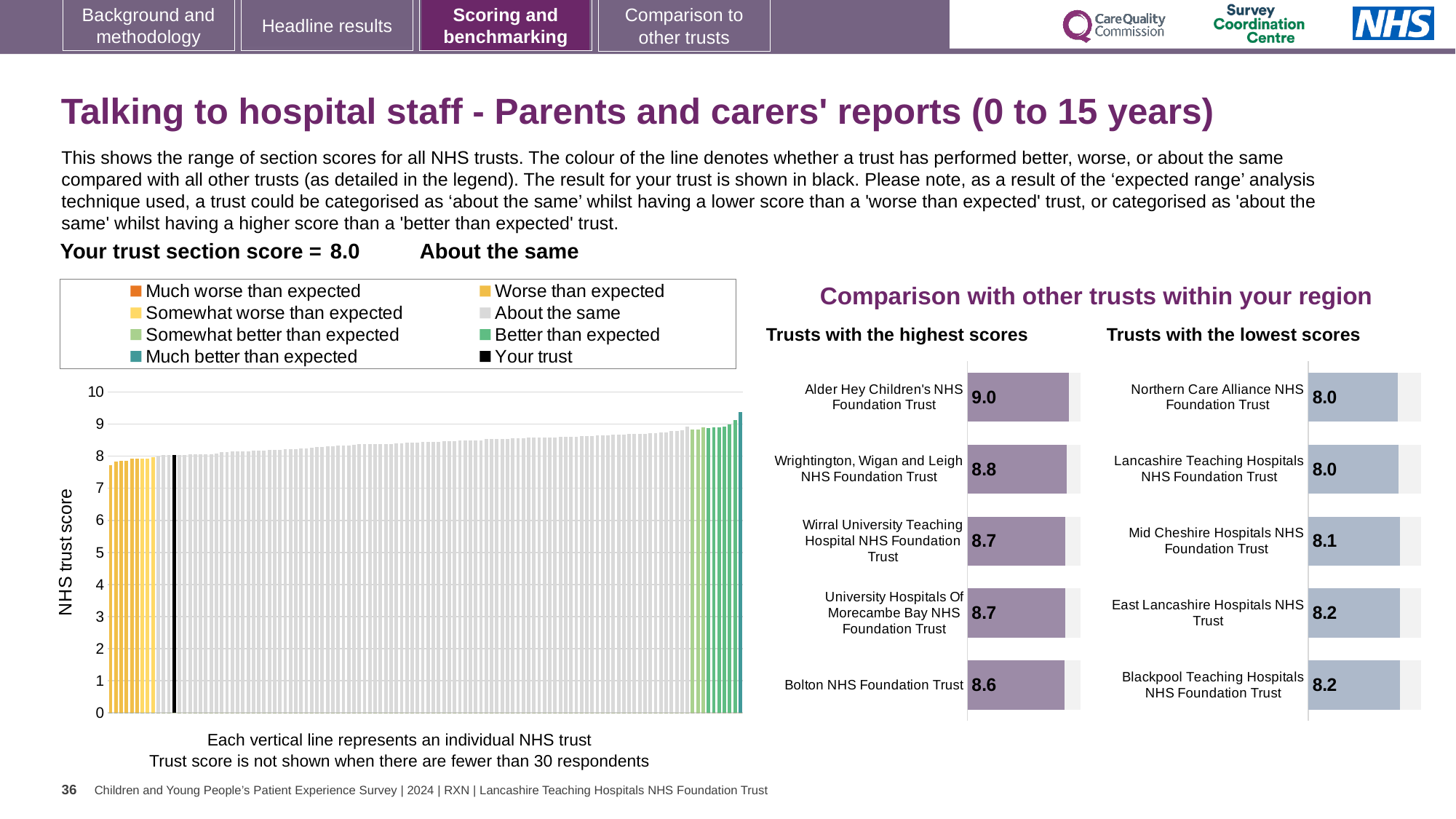
How many entries does the legend of the large chart on the left list? 8 In the large chart on the left, do the trust scores rise or fall from left to right? Rise In the 'Trusts with the lowest scores' chart, what is the difference between the scores of Blackpool Teaching Hospitals NHS Foundation Trust and Northern Care Alliance NHS Foundation Trust? 0.2 In the 'Trusts with the highest scores' chart, how many trusts are shown? 5 In the 'Trusts with the lowest scores' chart, which is larger: the score for Mid Cheshire Hospitals NHS Foundation Trust or East Lancashire Hospitals NHS Trust? East Lancashire Hospitals NHS Trust In the 'Trusts with the highest scores' chart, which trust has the highest score? Alder Hey Children's NHS Foundation Trust In the 'Trusts with the highest scores' chart, what is the difference between the scores of Alder Hey Children's NHS Foundation Trust and Bolton NHS Foundation Trust? 0.4 What kind of chart is the large chart on the left showing NHS trust scores? Bar chart In the 'Trusts with the highest scores' chart, what is the score for Alder Hey Children's NHS Foundation Trust? 9.0 In the 'Trusts with the highest scores' chart, what is the score for Bolton NHS Foundation Trust? 8.6 In the 'Trusts with the lowest scores' chart, what is the score for Blackpool Teaching Hospitals NHS Foundation Trust? 8.2 In the 'Trusts with the lowest scores' chart, what is the score for Mid Cheshire Hospitals NHS Foundation Trust? 8.1